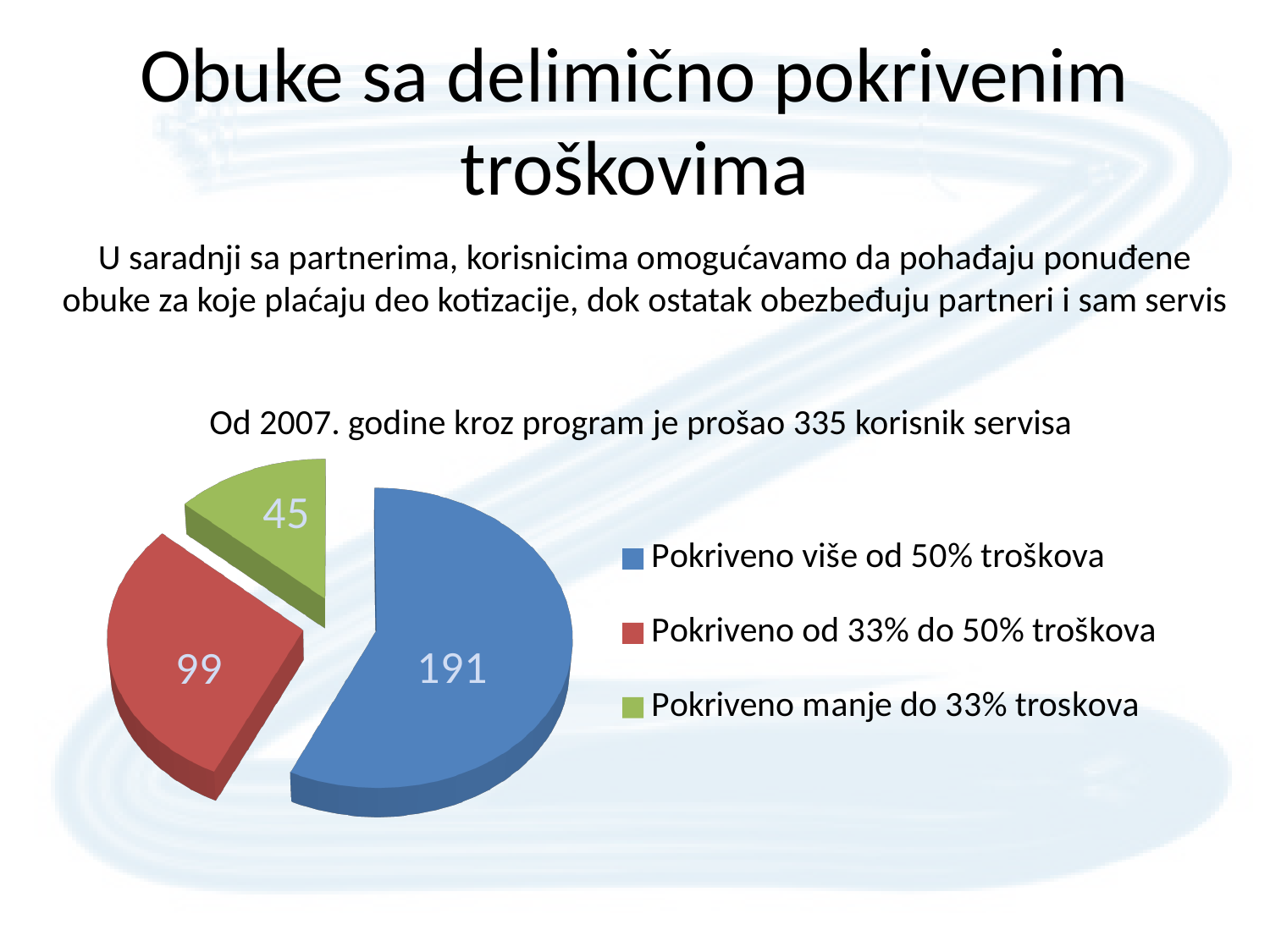
What is the difference between the values for "Pokriveno više od 50% troškova" and "Pokriveno od 33% do 50% troškova"? 92 What is the value for "Pokriveno više od 50% troškova" in the pie chart? 191 How many entries does the legend of the pie chart list? 3 What colour is the slice for "Pokriveno manje do 33% troskova"? green What is the value for "Pokriveno od 33% do 50% troškova" in the pie chart? 99 What kind of chart is shown on the slide? pie chart Which category has the smallest slice in the pie chart? Pokriveno manje do 33% troskova Which is larger: the value for "Pokriveno od 33% do 50% troškova" or "Pokriveno manje do 33% troskova"? Pokriveno od 33% do 50% troškova What is the value for "Pokriveno manje do 33% troskova" in the pie chart? 45 What is the total of all three slices in the pie chart? 335 How many slices does the pie chart have? 3 Which category has the largest slice in the pie chart? Pokriveno više od 50% troškova